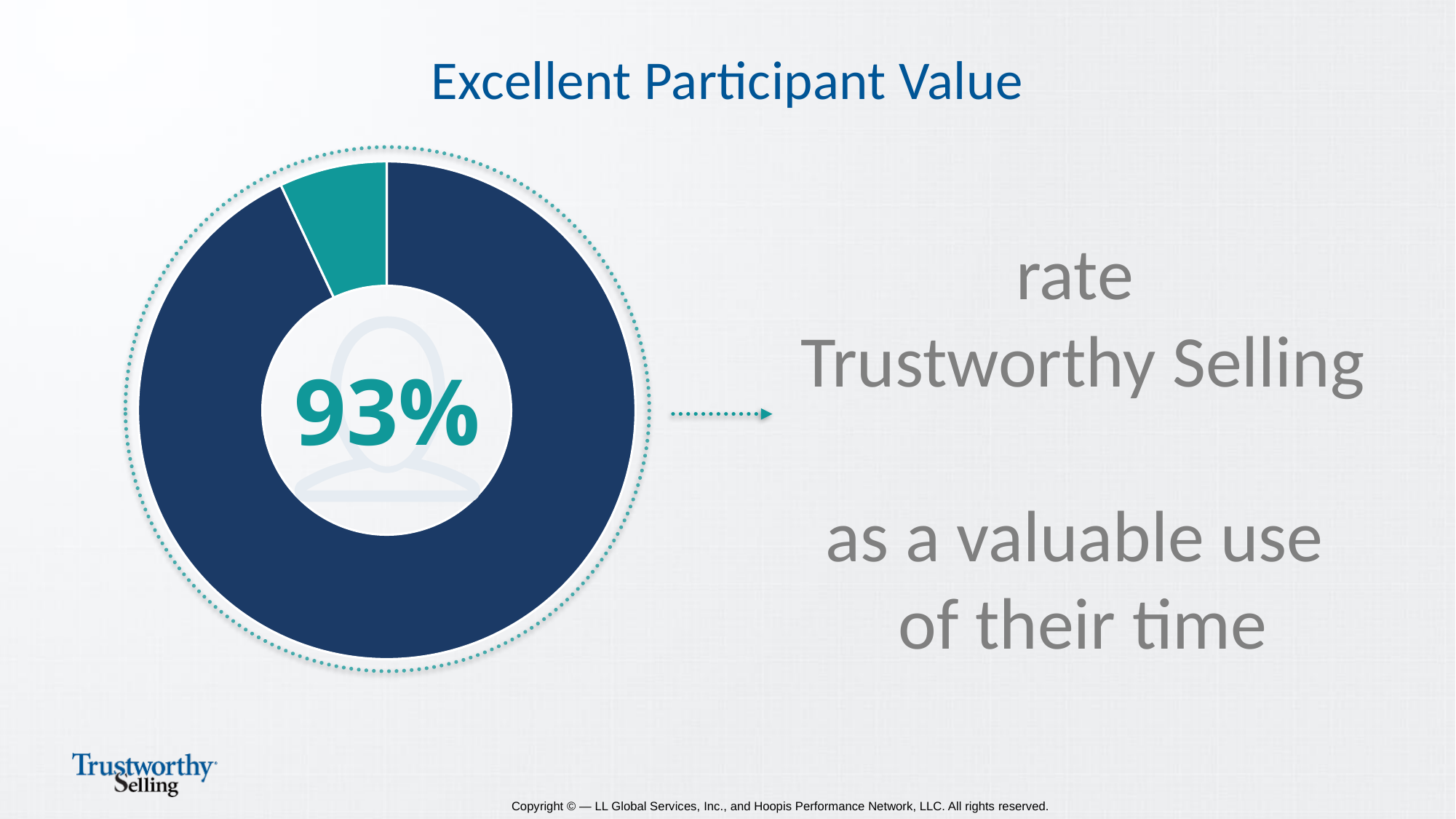
What share of the donut chart does the dark blue slice represent? 93% What kind of chart is shown on the slide? pie chart (donut) According to the text next to the chart, what does the 93% figure represent? participants who rate Trustworthy Selling as a valuable use of their time What is the title of the slide containing the donut chart? Excellent Participant Value How many slices does the donut chart have? 2 What percentage is printed in the center of the donut chart? 93% Is the share shown by the dark blue slice greater or less than 50%? greater Which slice of the donut chart is larger, the dark blue one or the teal one? the dark blue one